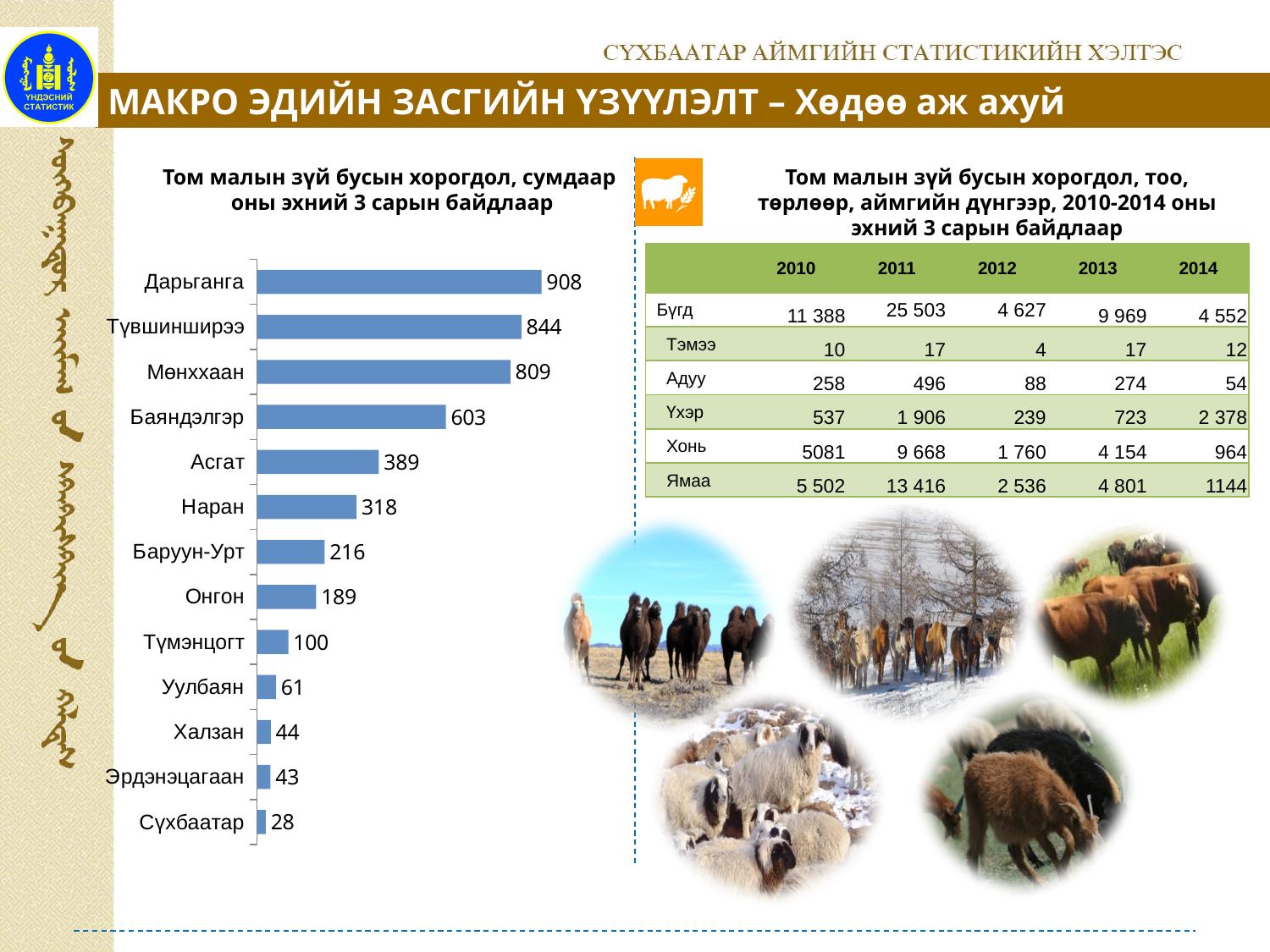
What is the value for Баяндэлгэр in the bar chart? 603 What is the difference between the values for Асгат and Наран in the bar chart? 71 Which is larger in the bar chart, the value for Мөнххаан or the value for Баяндэлгэр? Мөнххаан Which category has the highest value in the bar chart? Дарьганга Which category has the lowest value in the bar chart? Сүхбаатар What is the difference between the values for Дарьганга and Түвшинширээ in the bar chart? 64 What kind of chart is shown on the left of the slide? Bar chart How many categories are shown in the bar chart? 13 What is the value for Дарьганга in the bar chart? 908 What is the title of the bar chart? Том малын зүй бусын хорогдол, сумдаар оны эхний 3 сарын байдлаар What is the value for Онгон in the bar chart? 189 Which is larger in the bar chart, the value for Баруун-Урт or the value for Түмэнцогт? Баруун-Урт